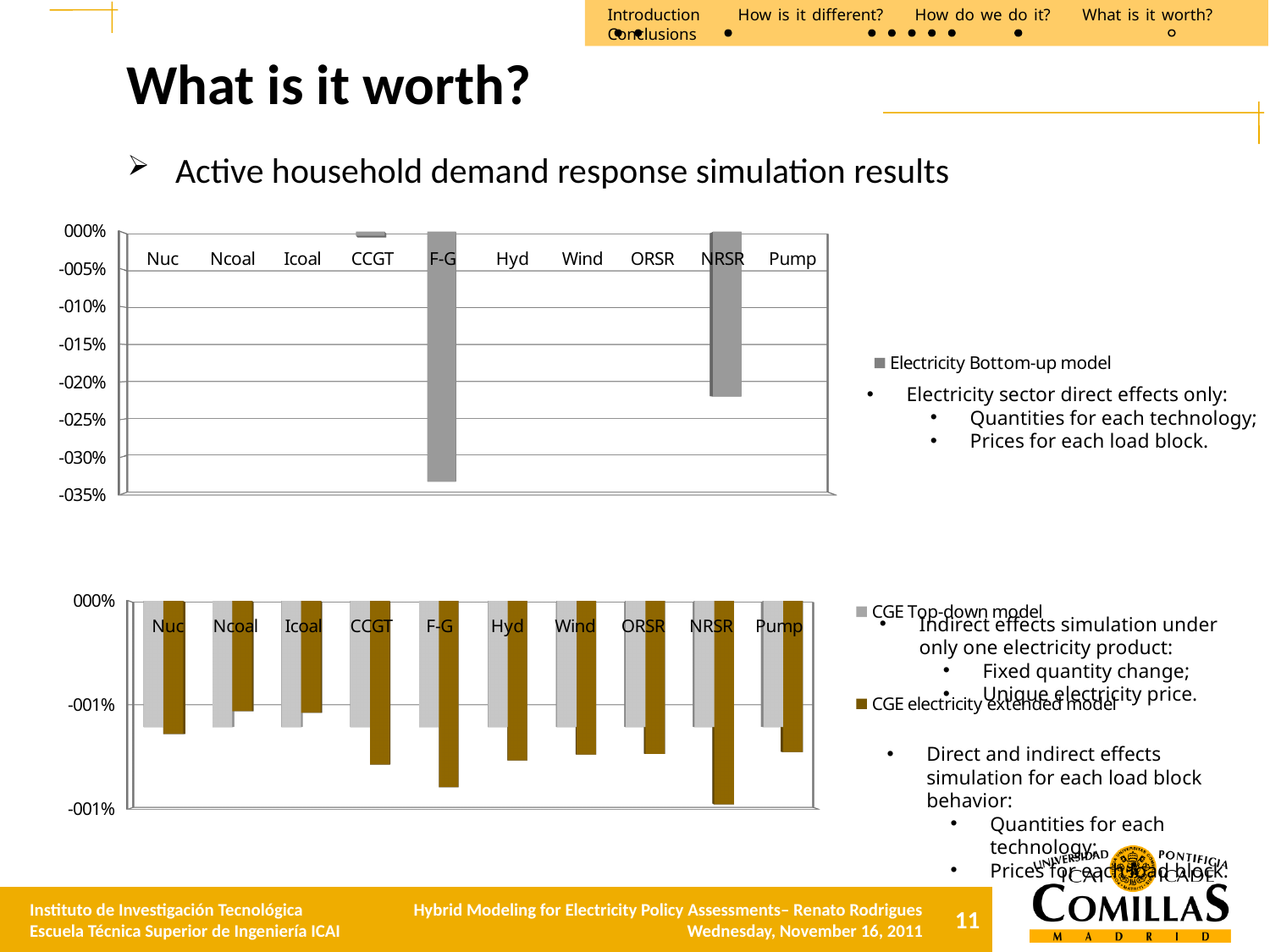
In the top chart, which has the lower value, F-G or NRSR? F-G In the bottom chart, which category has the lowest (most negative) value for the CGE electricity extended model series? NRSR What are the two series named in the legend of the bottom chart? CGE Top-down model; CGE electricity extended model What kind of chart is the top chart on the slide? Bar chart In the top chart, is the value for F-G greater or less than -030%? less What is the legend entry of the top chart? Electricity Bottom-up model In the top chart, is the value for NRSR greater or less than -020%? less How many categories are shown on the x axis of the top chart? 10 In the bottom chart, for the category F-G, which series has the lower (more negative) value, CGE Top-down model or CGE electricity extended model? CGE electricity extended model In the top chart, is the value for NRSR greater or less than -025%? greater How many series does the legend of the bottom chart list? 2 In the top chart, which category has the lowest (most negative) value? F-G